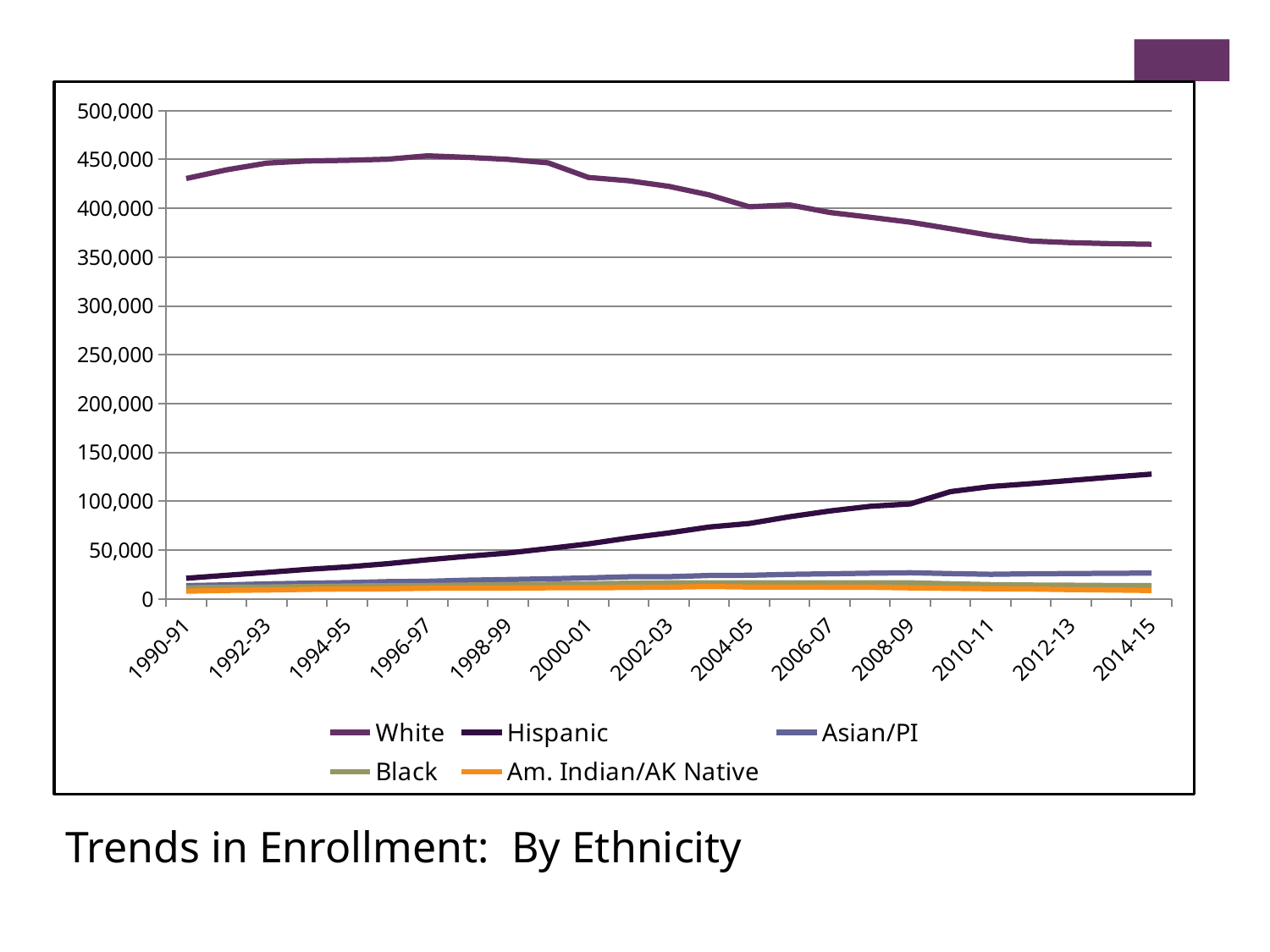
What kind of chart is shown on the slide? Line chart Which colour is used for the Am. Indian/AK Native line? Orange Does the Hispanic series rise or fall overall from 1990-91 to 2014-15? Rise Is the value for White in 1990-91 greater or less than 400,000? greater Which series has the highest enrollment across the whole period? White Does the White series rise or fall overall from 1990-91 to 2014-15? Fall Is the value for Hispanic in 1990-91 greater or less than 50,000? less How many series does the legend list? 5 Is the value for Hispanic in 2014-15 greater or less than 100,000? greater What is the title of the chart? Trends in Enrollment: By Ethnicity How many year labels are shown on the x axis? 13